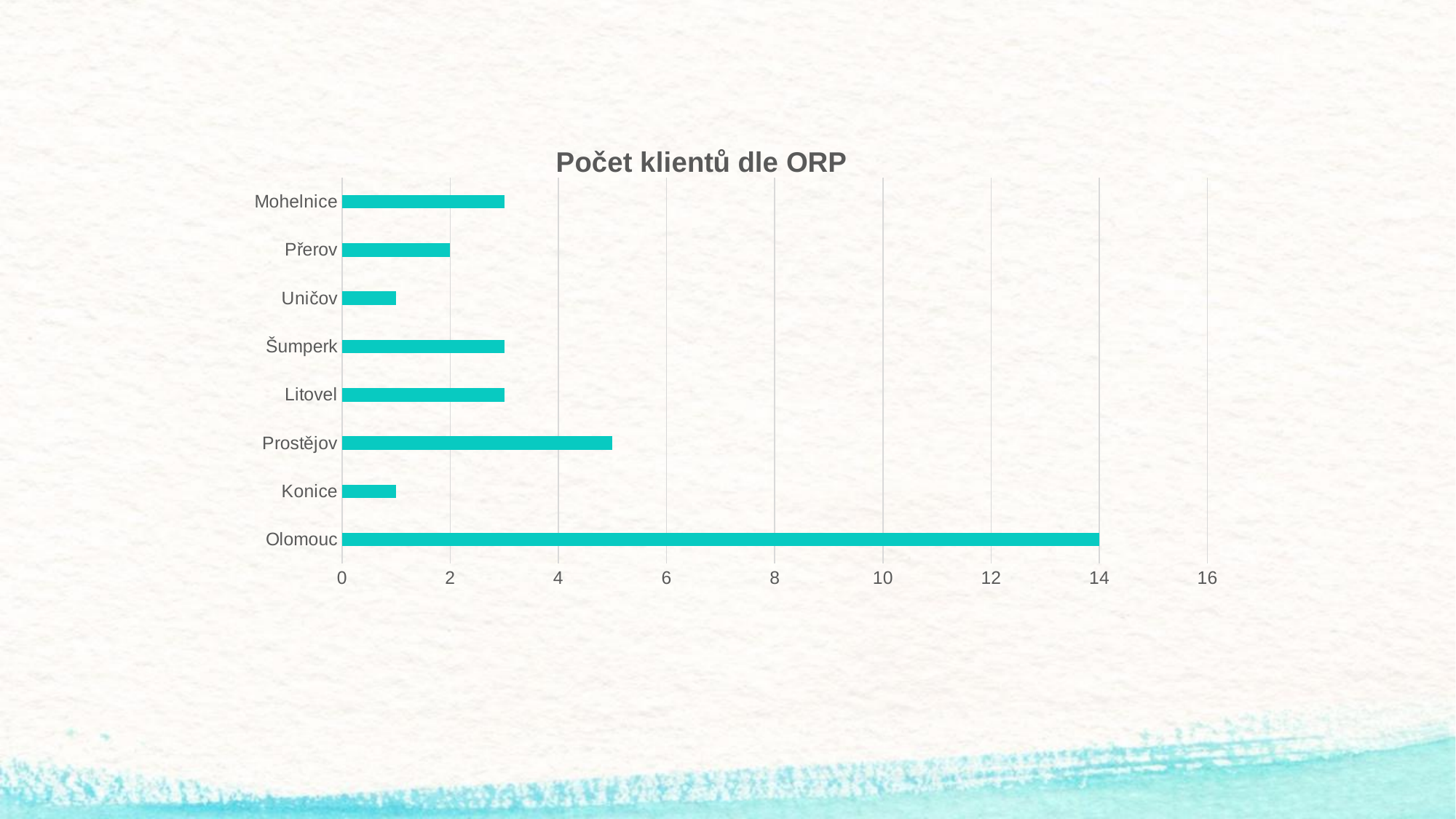
How many categories (ORP) are shown in the chart? 8 Is the value for Prostějov greater or less than 4? greater Which ORP has the highest number of clients? Olomouc What is the value for Olomouc? 14 What is the value for Přerov? 2 Is the value for Šumperk greater or less than 4? less What is the title of the chart? Počet klientů dle ORP Is the value for Uničov greater or less than 2? less What type of chart is shown on the slide? bar chart Which has a larger value, Prostějov or Litovel? Prostějov What is the difference between the values for Olomouc and Přerov? 12